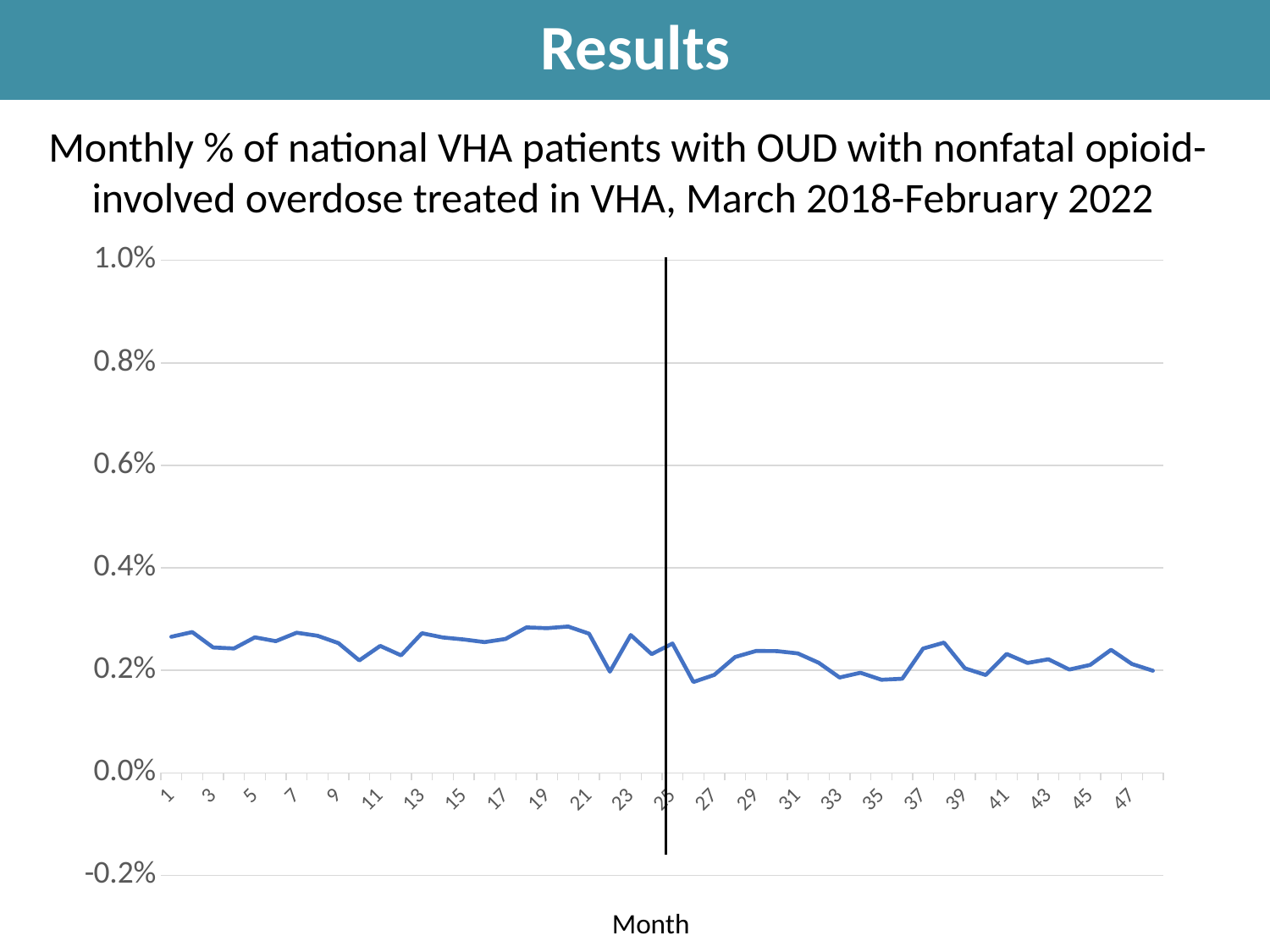
Which is larger, the value for month 19 or the value for month 26? month 19 What kind of chart is shown on the slide? line chart How many monthly data points are plotted on the line? 48 Is the value for month 48 greater or less than 0.4%? less What is the title of the chart? Monthly % of national VHA patients with OUD with nonfatal opioid-involved overdose treated in VHA, March 2018-February 2022 Which is larger, the value for month 2 or the value for month 36? month 2 Is the value for month 1 greater or less than 0.2%? greater Is the value for month 13 greater or less than 0.2%? greater Overall, do the values rise or fall from month 1 to month 48? fall What is the label of the x axis? Month